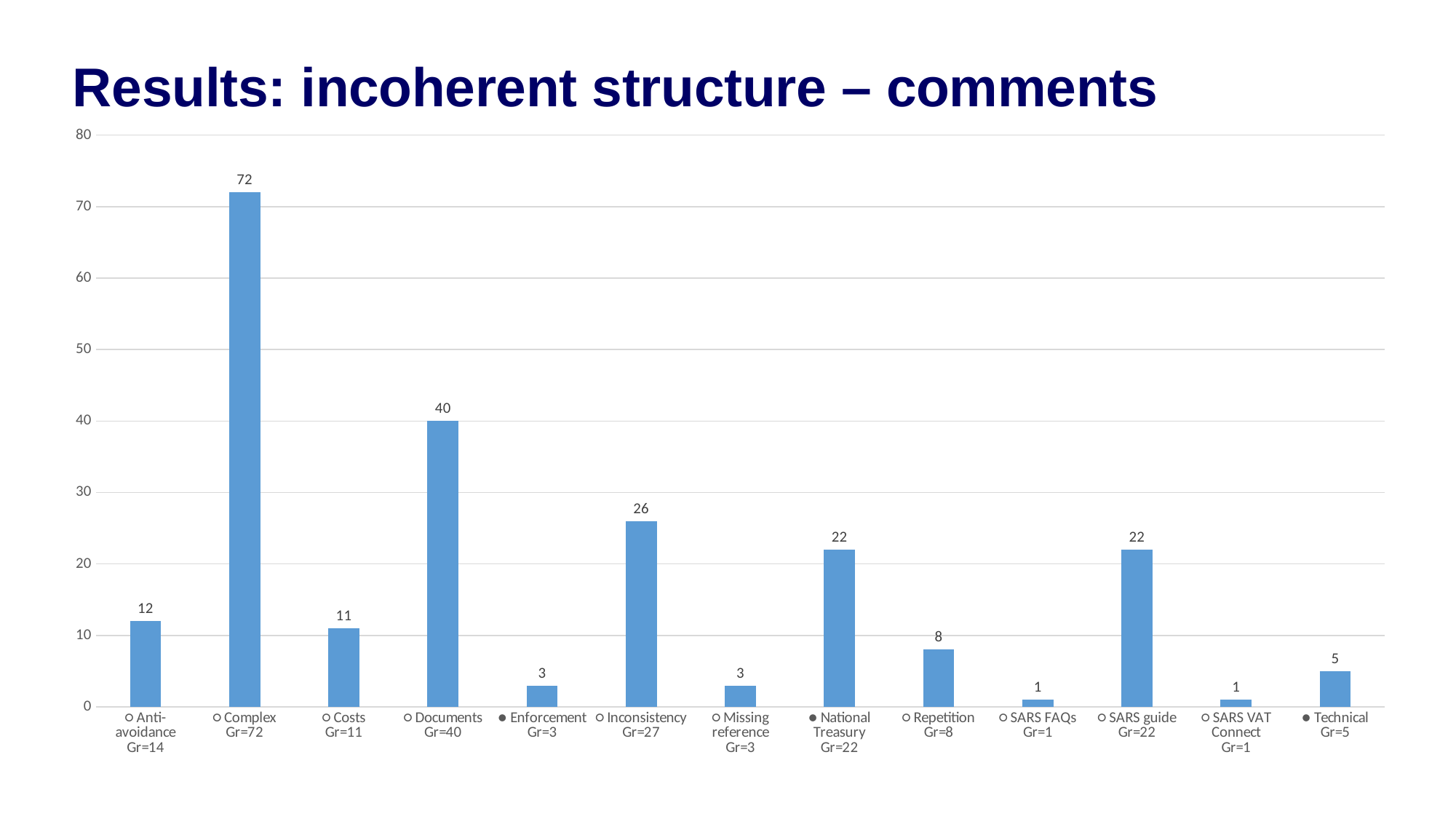
Which category has the highest bar? Complex Is the value for Inconsistency greater or less than 30? less What is the value of the bar for Repetition? 8 What is the title of the slide? Results: incoherent structure – comments What is the difference between the values for Complex and Documents? 32 Which is larger, the value for Anti-avoidance or the value for Costs? Anti-avoidance What is the value of the bar for Complex? 72 What is the difference between the values for National Treasury and Technical? 17 What type of chart is shown on the slide? bar chart What is the value of the bar for Documents? 40 How many categories are shown on the x axis? 13 What is the value of the bar for Inconsistency? 26